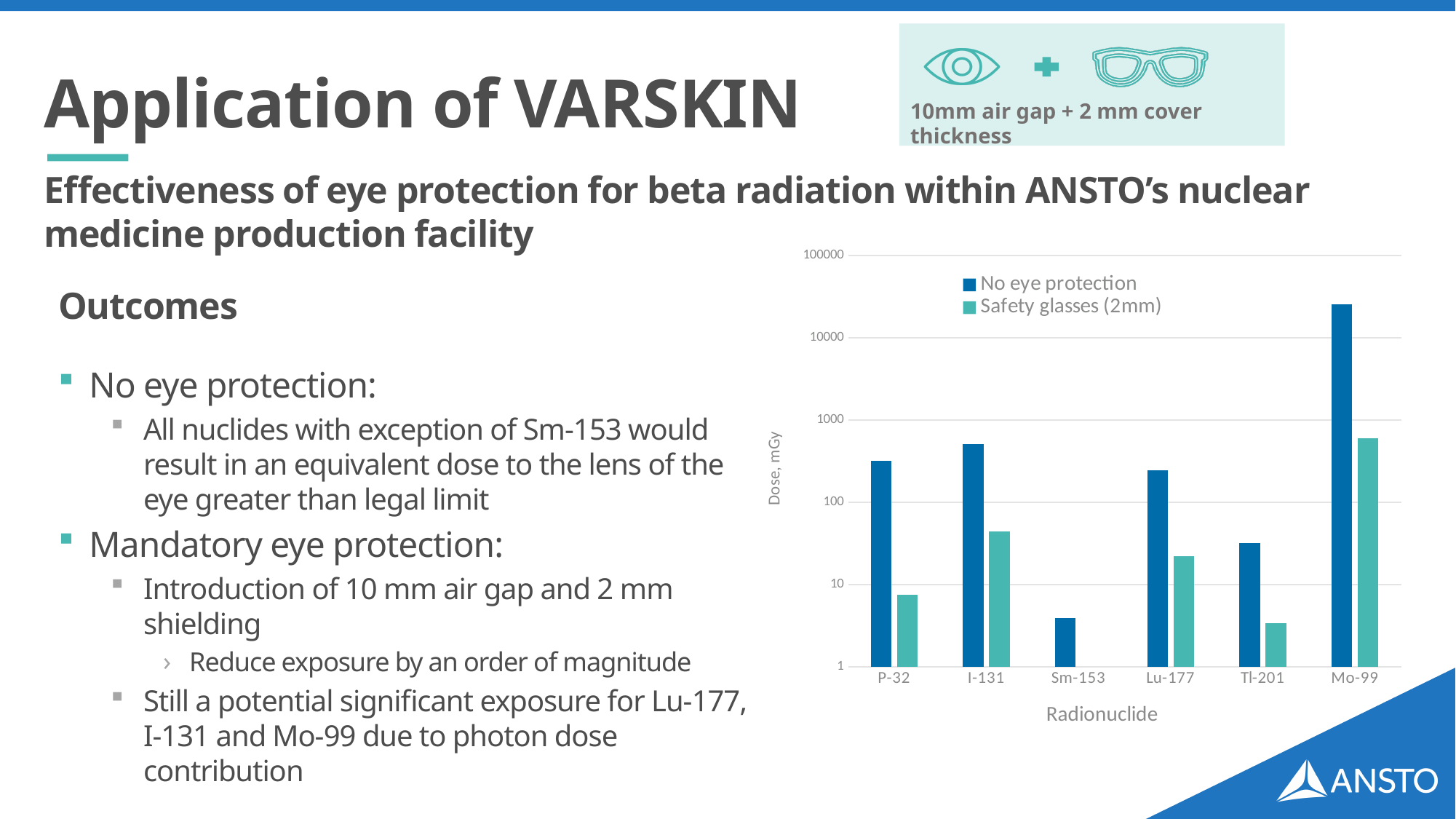
Is the no eye protection dose for Tl-201 greater or less than 100 mGy? less Which radionuclide has the highest dose with safety glasses (2mm)? Mo-99 Is the no eye protection dose for Mo-99 greater or less than 10000 mGy? greater Which radionuclide has the lowest dose with no eye protection? Sm-153 Is the safety glasses (2mm) dose for Mo-99 greater or less than 1000 mGy? less What is the label on the y axis of the chart? Dose, mGy With no eye protection, which has the larger dose: I-131 or P-32? I-131 What kind of chart is shown on the slide? bar chart Which radionuclide has the highest dose with no eye protection? Mo-99 How many radionuclides are shown on the x axis of the chart? 6 How many series does the chart legend list? 2